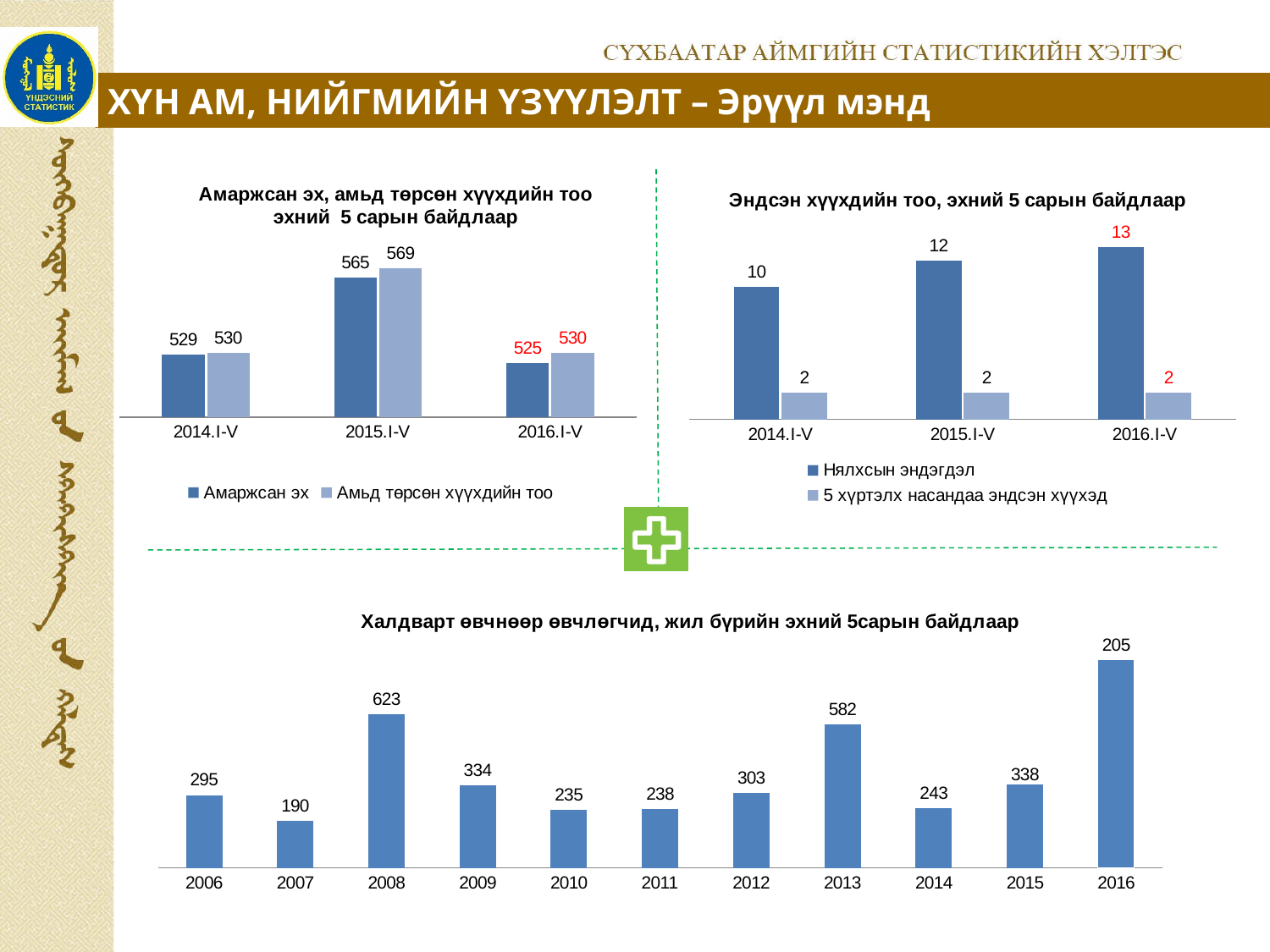
In the top-right chart (Эндсэн хүүхдийн тоо), what is the value of Нялхсын эндэгдэл for 2016.I-V? 13 In the top-left chart (Амаржсан эх, амьд төрсөн хүүхдийн тоо), what is the value of Амаржсан эх for 2015.I-V? 565 In the top-right chart (Эндсэн хүүхдийн тоо), does the Нялхсын эндэгдэл series rise or fall from 2014.I-V to 2016.I-V? rise In the top-left chart (Амаржсан эх, амьд төрсөн хүүхдийн тоо), what is the difference between Амьд төрсөн хүүхдийн тоо and Амаржсан эх for 2016.I-V? 5 In the bottom chart (Халдварт өвчнөөр өвчлөгчид), which year has the lowest value? 2007 In the top-left chart (Амаржсан эх, амьд төрсөн хүүхдийн тоо), how many series does the legend list? 2 In the bottom chart (Халдварт өвчнөөр өвчлөгчид), what is the value for 2008? 623 What kind of chart is the top-right chart (Эндсэн хүүхдийн тоо)? bar chart In the bottom chart (Халдварт өвчнөөр өвчлөгчид), how many years are shown on the x axis? 11 In the bottom chart (Халдварт өвчнөөр өвчлөгчид), is the value for 2015 larger or smaller than the value for 2012? larger